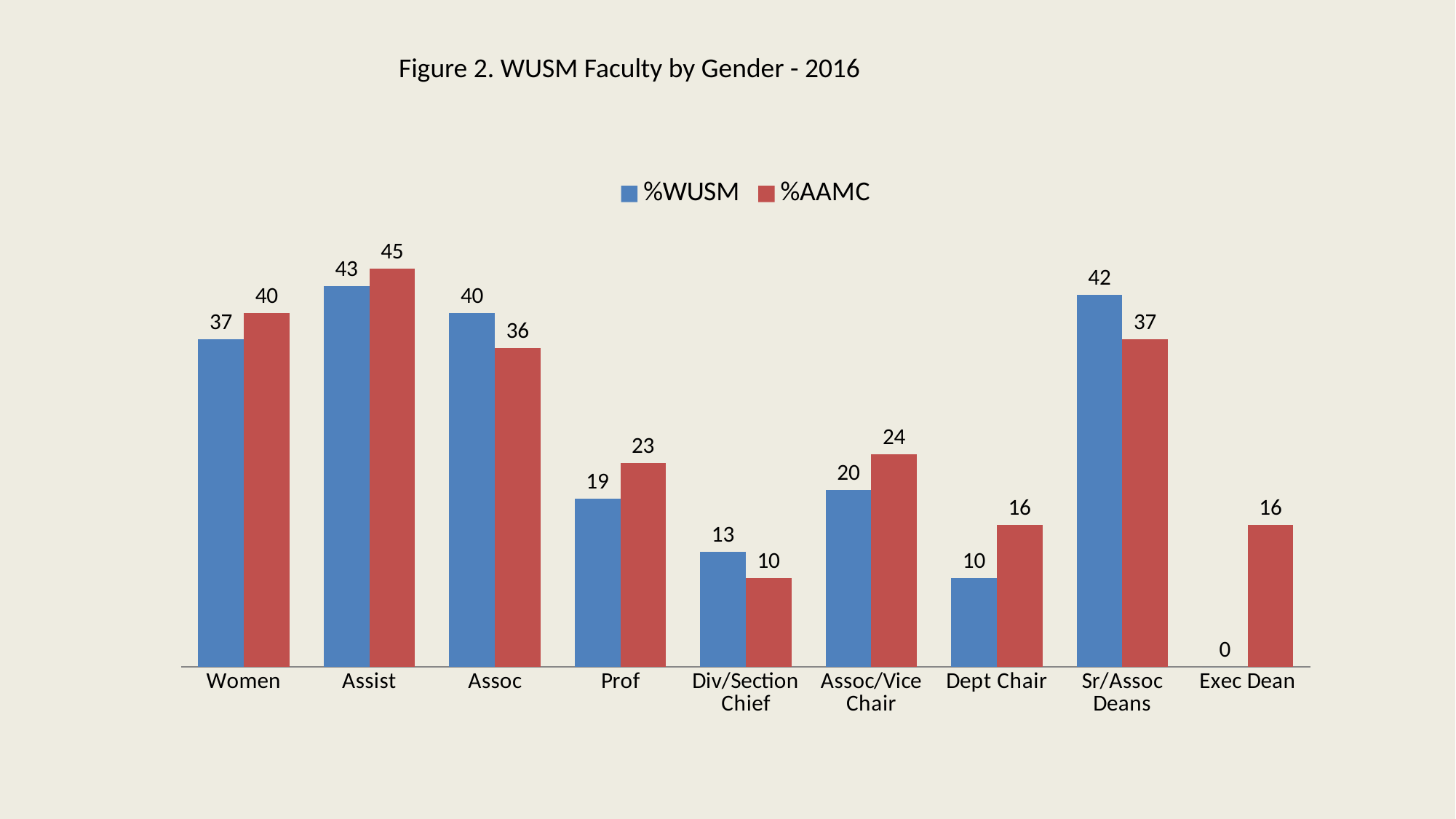
What is the title of the chart? Figure 2. WUSM Faculty by Gender - 2016 Which category has the highest %WUSM value? Assist What kind of chart is shown on the slide? Bar chart Which is larger for Prof, %WUSM or %AAMC? %AAMC What is the %WUSM value for Women? 37 What is the %AAMC value for Assist? 45 What is the %WUSM value for Exec Dean? 0 Which is larger for Sr/Assoc Deans, %WUSM or %AAMC? %WUSM How many categories are shown on the x axis? 9 How many series does the legend list? 2 Which category has the lowest %AAMC value? Div/Section Chief What is the difference between the %AAMC and %WUSM values for Dept Chair? 6